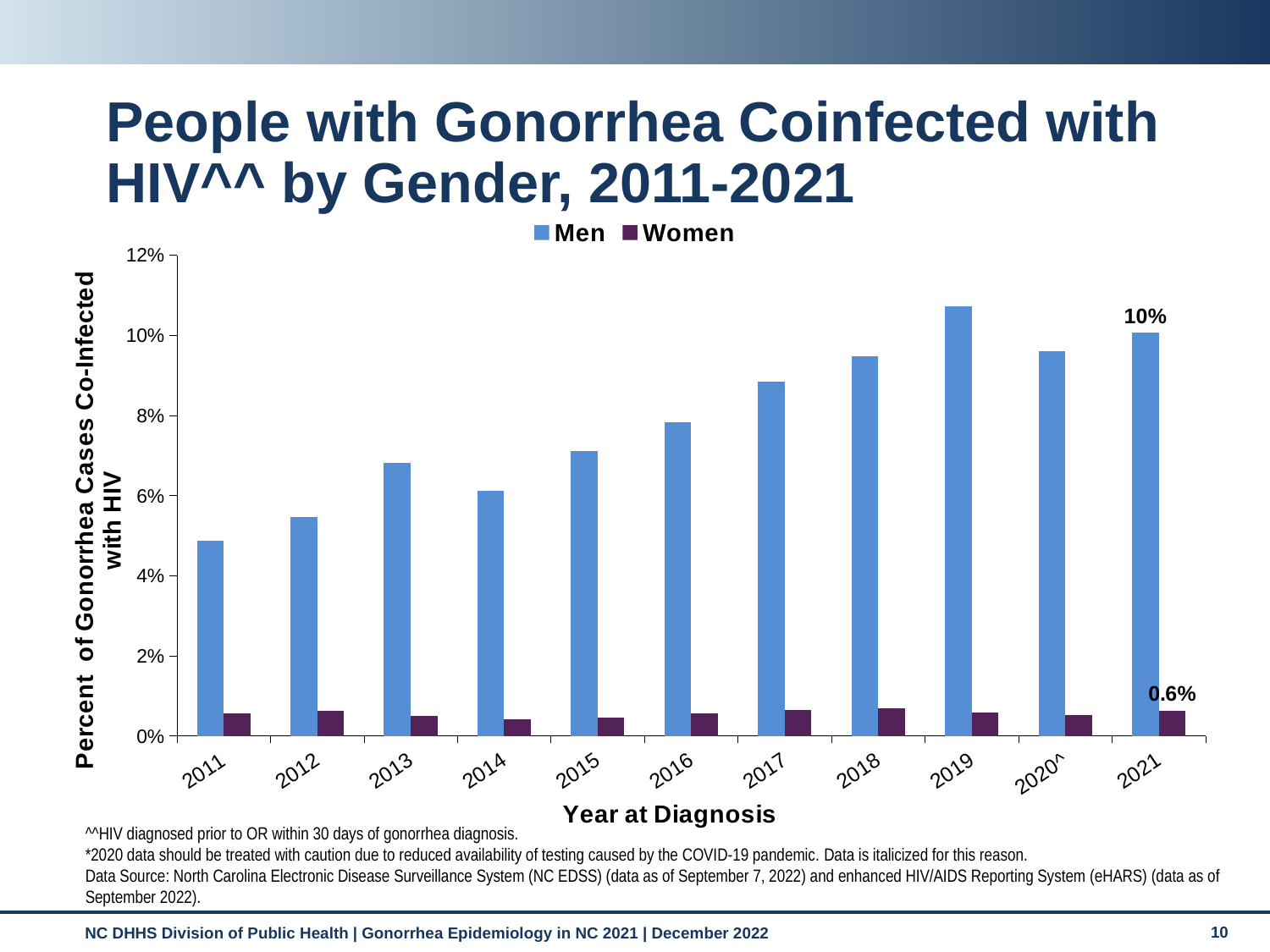
How many series does the legend list? 2 Do the values for Men generally rise or fall from 2011 to 2019? rise How many years are shown on the x axis? 11 In which year is the value for Men the highest? 2019 Which is larger for Men, the value in 2017 or the value in 2018? 2018 Is the value for Men in 2019 greater or less than 10%? greater What is the difference between the Men and Women values in 2021? 9.4 percentage points What is the value for Women in 2021? 0.6% What kind of chart is shown on the slide? bar chart Is the value for Men in 2011 greater or less than 6%? less In which year is the value for Men the lowest? 2011 What is the value for Men in 2021? 10%